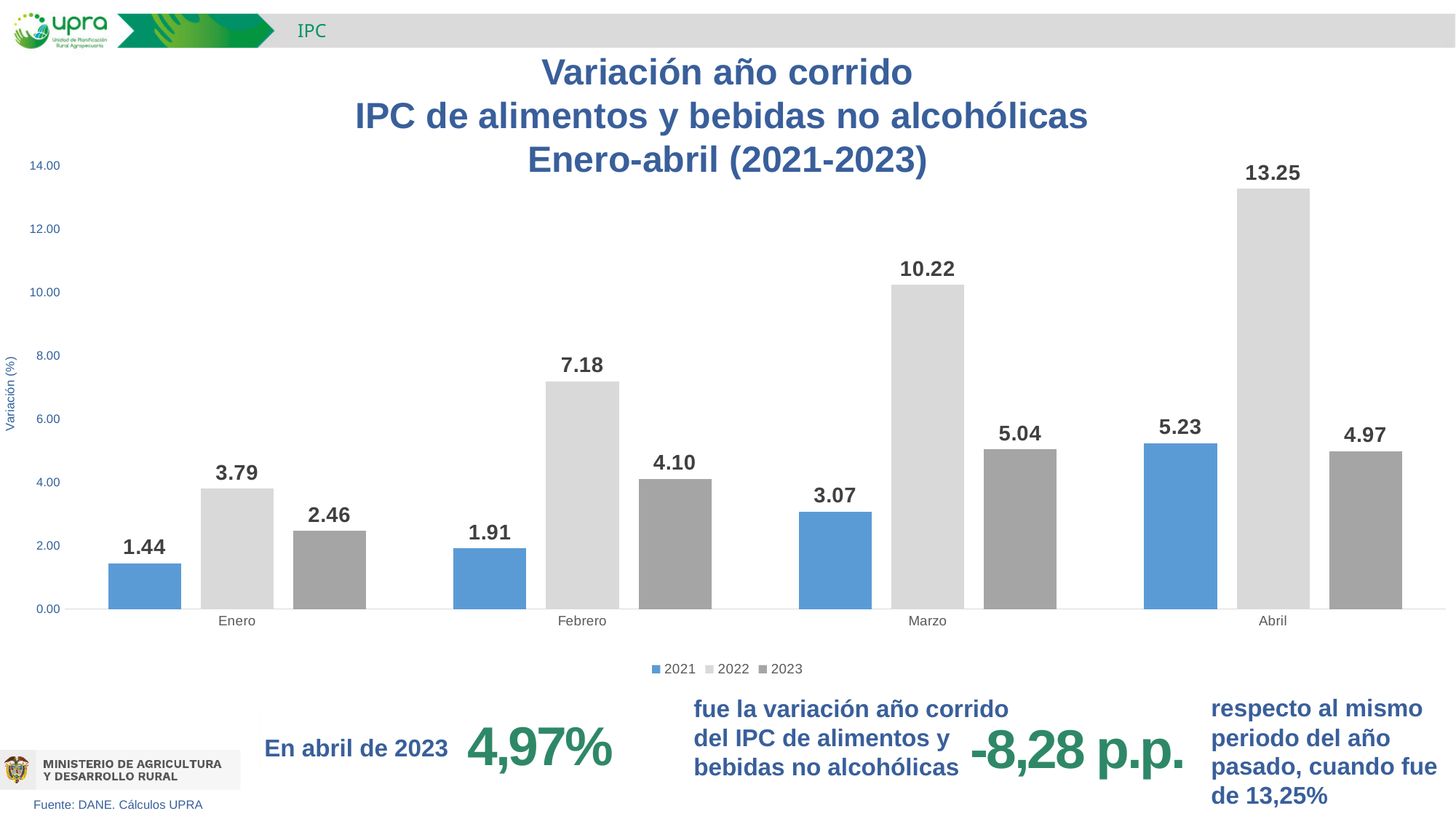
What kind of chart is shown on the slide? Bar chart What is the difference between the 2022 and 2023 values in Abril? 8.28 How many series does the legend list? 3 What is the value for 2022 in Abril? 13.25 Which month has the highest value for the 2022 series? Abril Do the values for the 2023 series rise or fall from Enero to Marzo? Rise Is the value for 2022 in Marzo greater or less than 10.00? greater Which month has the lowest value for the 2021 series? Enero Which is larger in Febrero: the 2021 value or the 2023 value? 2023 What is the value for 2023 in Marzo? 5.04 How many months are shown on the x axis? 4 What is the value for 2021 in Enero? 1.44